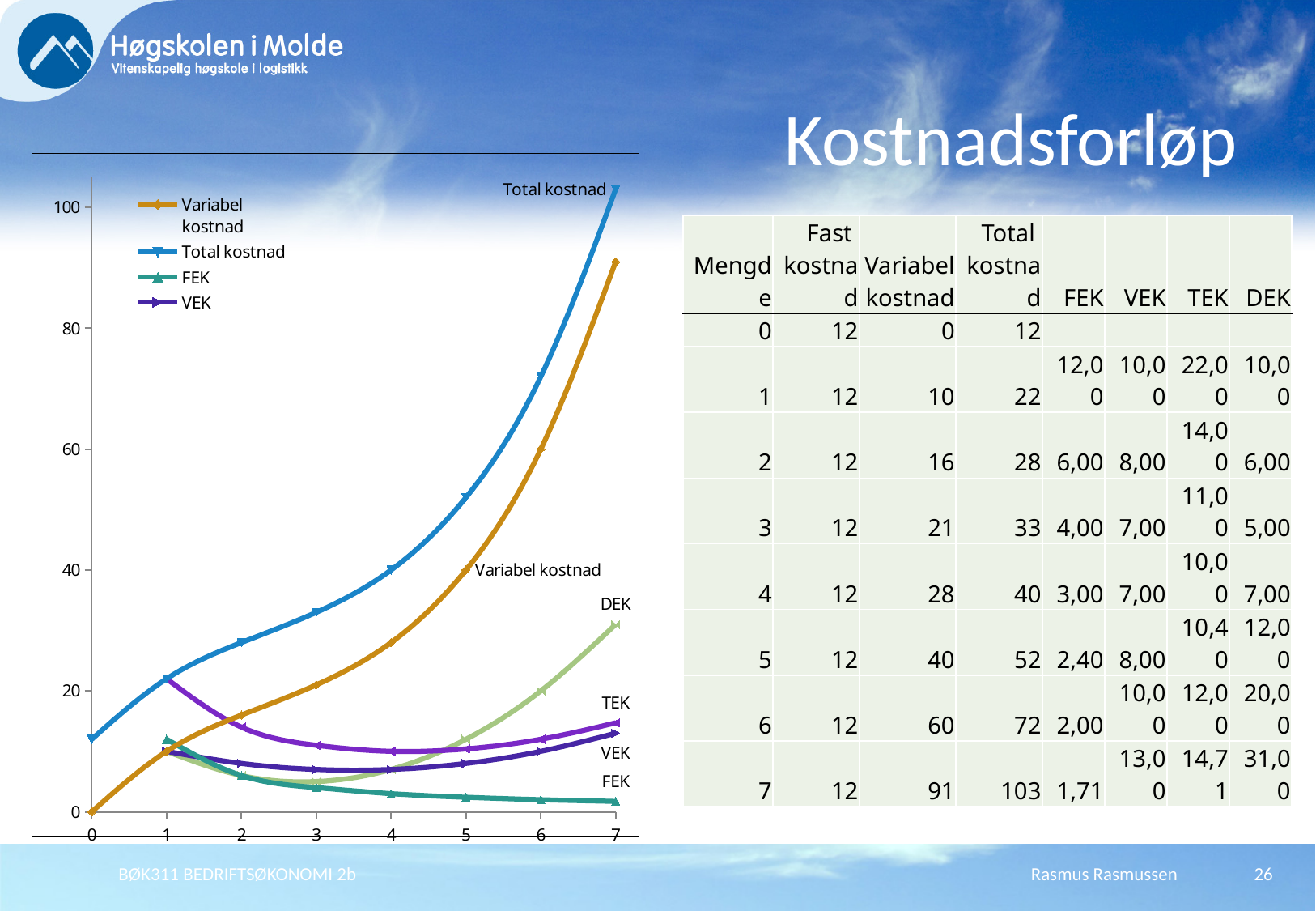
Which series has the lowest value at x = 7? FEK How many series does the chart's legend list? 4 What kind of chart is shown on the slide? line chart Is the value of Variabel kostnad at x = 4 greater or less than 40? less Is the value of Total kostnad at x = 7 greater or less than 100? greater According to the table on the slide, what is Total kostnad at Mengde 7? 103 Which series are listed in the chart's legend? Variabel kostnad, Total kostnad, FEK, VEK Is the value of Total kostnad at x = 0 greater or less than 20? less Does the FEK line rise or fall as the x axis goes from 1 to 7? fall At x = 7, which is larger: Total kostnad or Variabel kostnad? Total kostnad Does the Total kostnad line rise or fall as the x axis goes from 0 to 7? rise Which series reaches the highest value at x = 7? Total kostnad